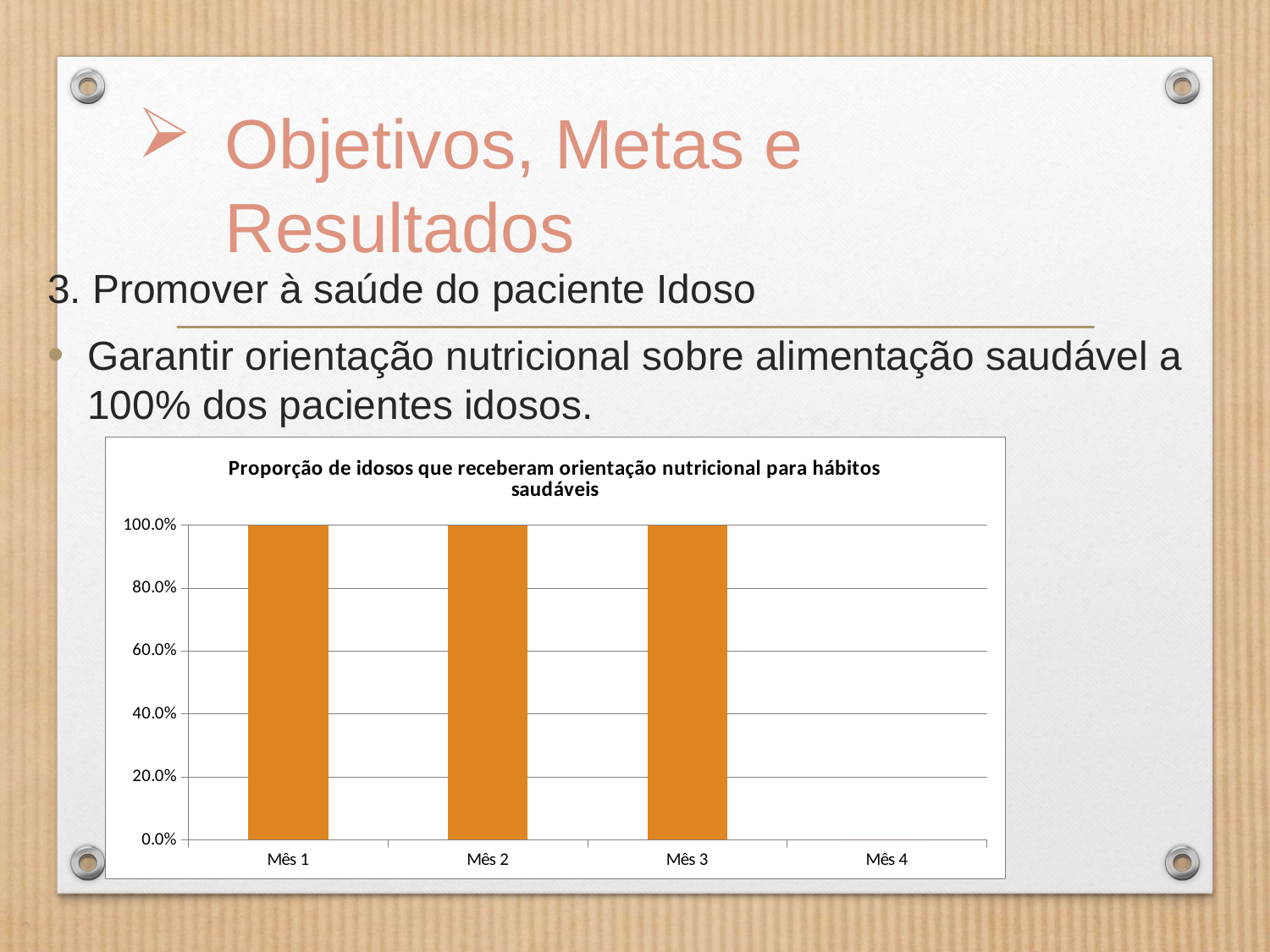
What is the value for Mês 1? 100.0% How many categories are shown on the x axis? 4 What is the value for Mês 2? 100.0% What is the difference between the values for Mês 1 and Mês 3? 0.0% What kind of chart is shown on the slide? bar chart Do the values change from Mês 1 to Mês 3? No, they stay at 100.0% What is the value for Mês 3? 100.0% What is the highest value shown on the y axis? 100.0% Is the value for Mês 2 greater or less than 80.0%? greater Which category has no visible bar? Mês 4 How many bars are visible in the chart? 3 What is the title of the chart? Proporção de idosos que receberam orientação nutricional para hábitos saudáveis